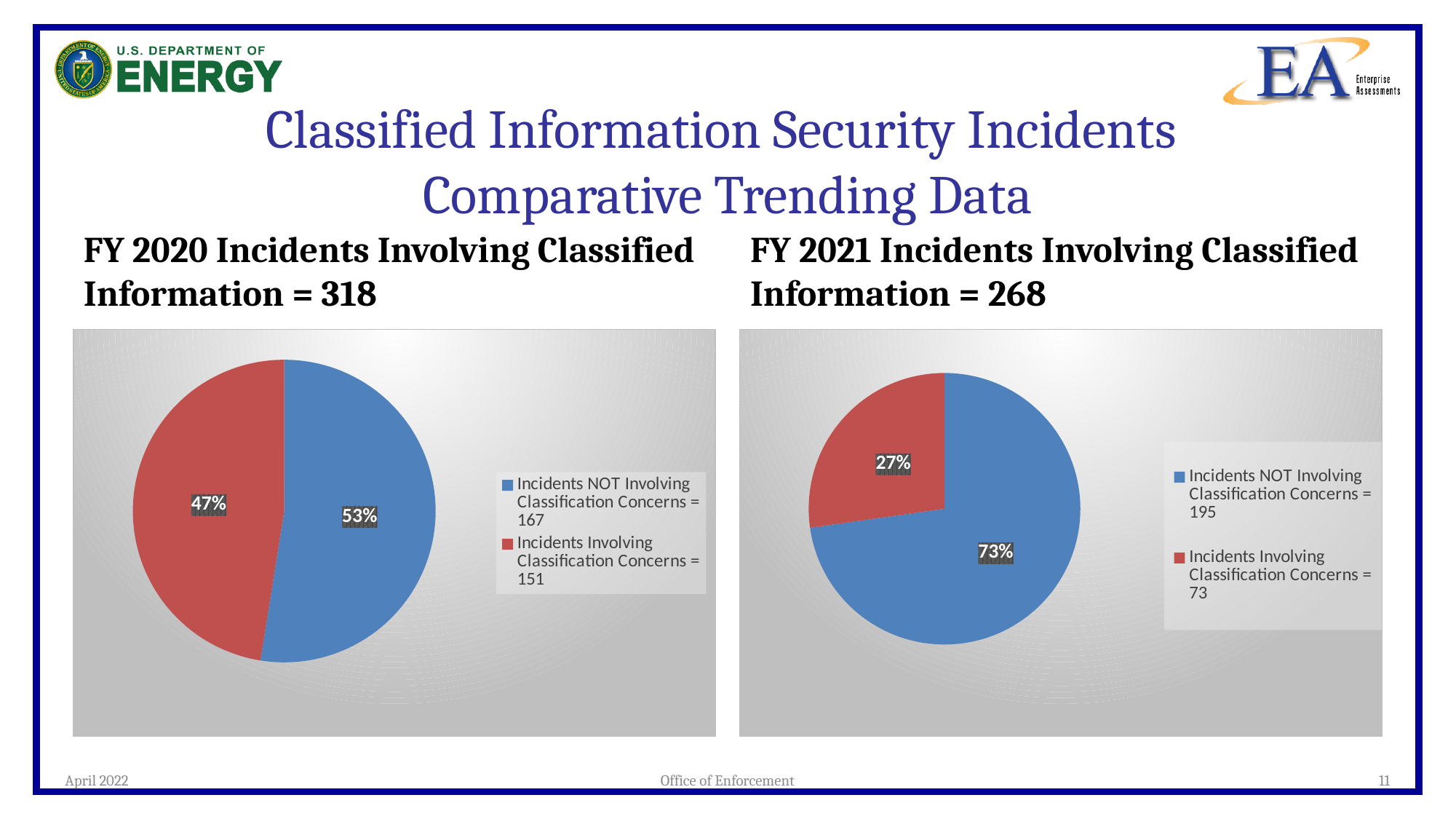
How many slices does the FY 2021 pie chart have? 2 According to the FY 2021 chart legend, how many incidents did NOT involve classification concerns? 195 In the FY 2021 pie chart, what is the difference in percentage points between the two slices? 46 In the FY 2021 pie chart, which slice is the largest? Incidents NOT Involving Classification Concerns In the FY 2020 pie chart, what is the difference in percentage points between the two slices? 6 In the FY 2021 pie chart, what percentage of incidents involved classification concerns? 27% In the FY 2020 pie chart, what percentage of incidents did NOT involve classification concerns? 53% In the FY 2020 pie chart, what percentage of incidents involved classification concerns? 47% In the FY 2021 pie chart, what percentage of incidents did NOT involve classification concerns? 73% What type of chart is used on the left side of the slide for FY 2020? Pie chart In the FY 2020 pie chart, which slice is the smallest? Incidents Involving Classification Concerns According to the FY 2020 chart legend, how many incidents involved classification concerns? 151